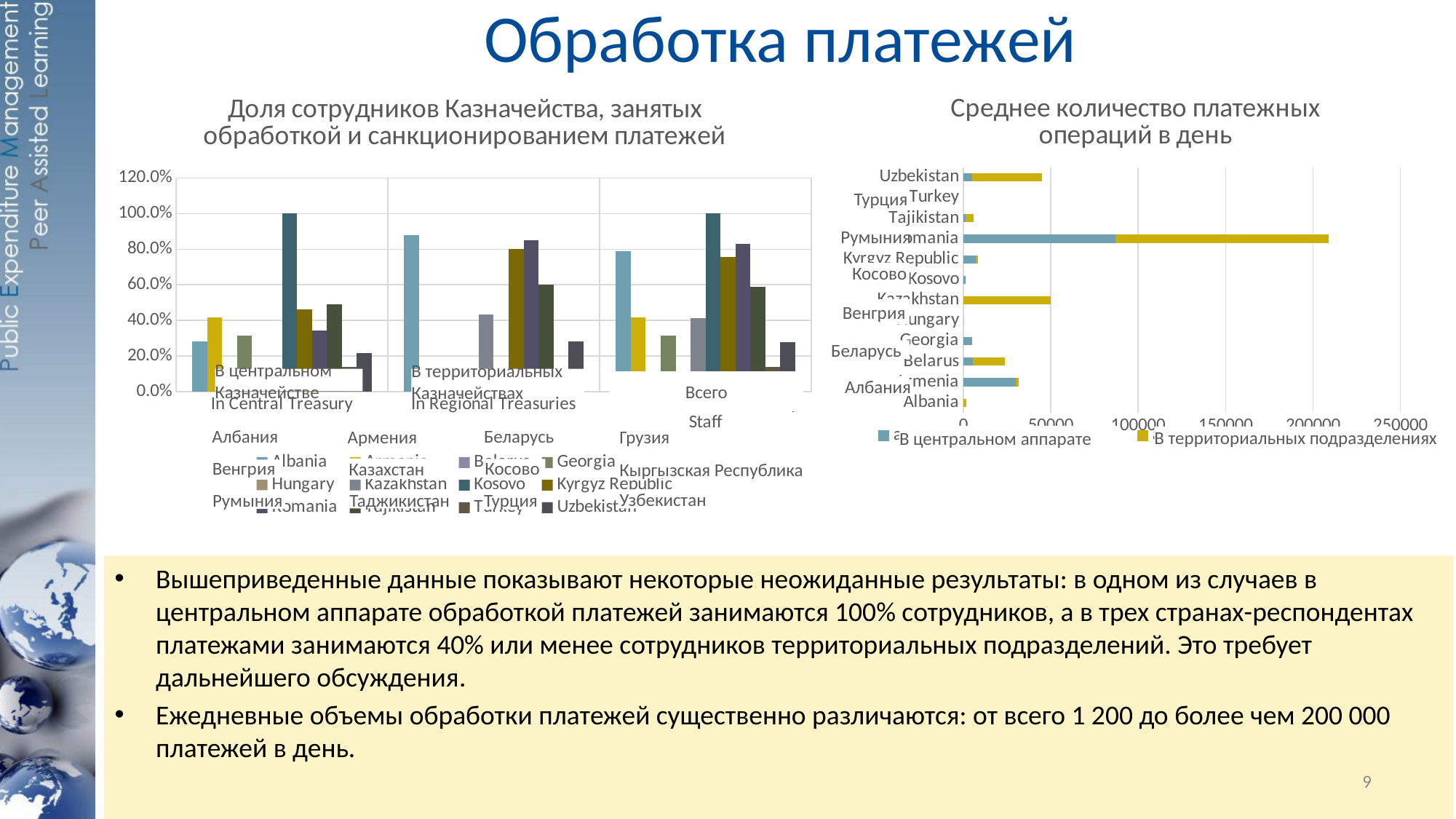
On the chart "Доля сотрудников Казначейства, занятых обработкой и санкционированием платежей", which country has the highest bar in the "In Central Treasury" group? Kosovo On the chart "Среднее количество платежных операций в день", which country has the longest bar? Romania On the chart "Доля сотрудников Казначейства, занятых обработкой и санкционированием платежей", is the value for Kosovo in the "In Central Treasury" group greater or less than 80.0%? greater On the chart "Среднее количество платежных операций в день", which series is shown in yellow? В территориальных подразделениях How many series does the legend of the chart "Доля сотрудников Казначейства, занятых обработкой и санкционированием платежей" list? 12 How many countries are shown on the chart "Среднее количество платежных операций в день"? 12 How many series does the legend of the chart "Среднее количество платежных операций в день" list? 2 On the chart "Среднее количество платежных операций в день", is the total bar for Belarus greater or less than 50000? less On the chart "Доля сотрудников Казначейства, занятых обработкой и санкционированием платежей", in the "In Central Treasury" group, which is larger: Kosovo or Armenia? Kosovo What kind of chart is the chart titled "Доля сотрудников Казначейства, занятых обработкой и санкционированием платежей"? bar chart What kind of chart is the chart titled "Среднее количество платежных операций в день"? bar chart On the chart "Среднее количество платежных операций в день", is the total bar for Romania greater or less than 150000? greater